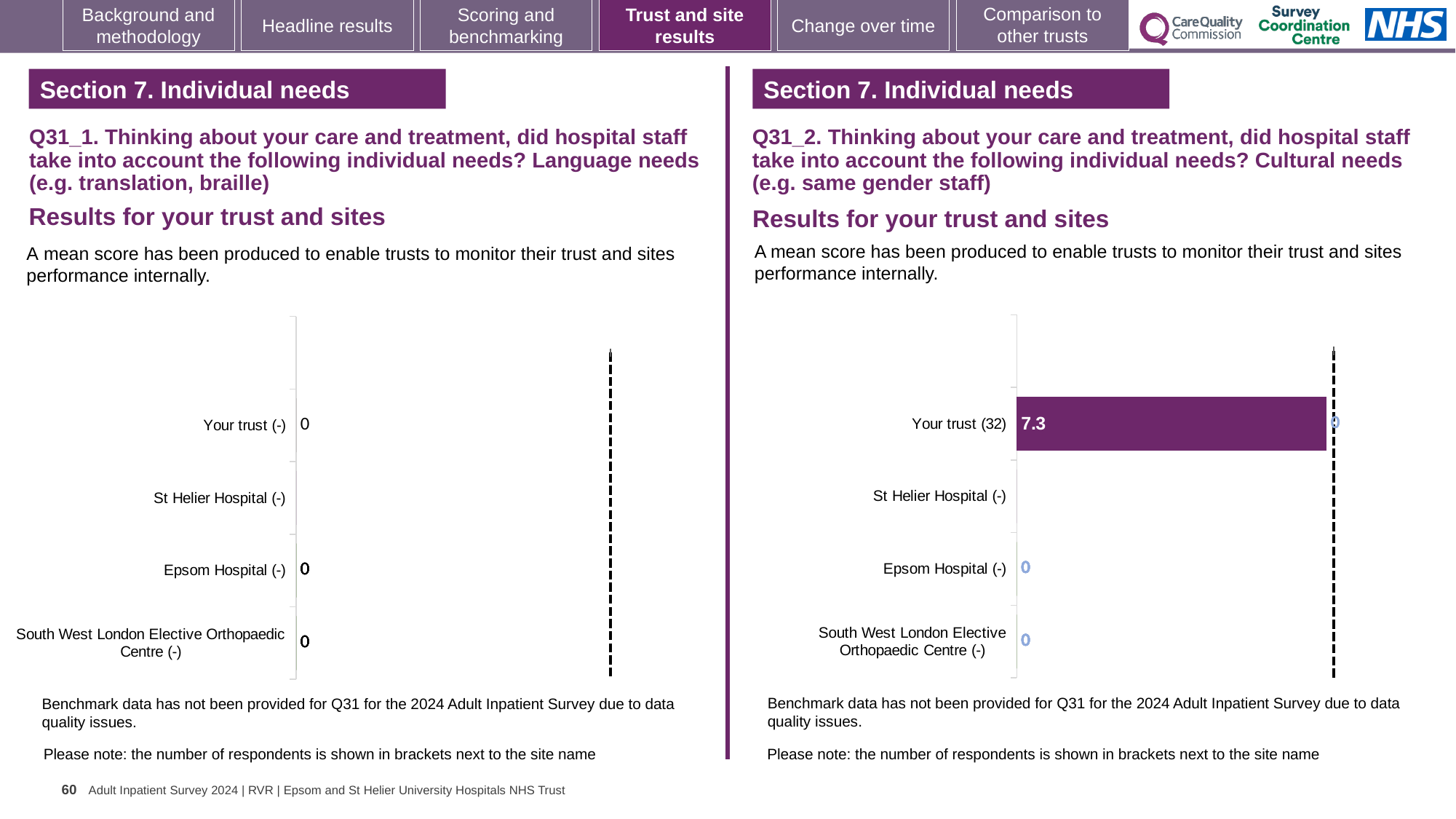
On the Q31_2 chart (right), which is larger: the value for Your trust (32) or the value for Epsom Hospital (-)? Your trust (32) On the Q31_2 chart (right), which category has the highest mean score? Your trust (32) On the Q31_2 chart (right), what value is shown for South West London Elective Orthopaedic Centre (-)? 0 On the Q31_2 chart (right), how many categories are listed on the vertical axis? 4 On the Q31_1 chart (left), what value is shown for Your trust (-)? 0 On the Q31_2 chart (right), how many respondents are shown in brackets for Your trust? 32 What kind of chart is used on the Q31_2 chart (right)? Bar chart On the Q31_2 chart (right), what is the difference between the value for Your trust (32) and the value for Epsom Hospital (-)? 7.3 On the Q31_2 chart (right), what is the mean score for Your trust (32)? 7.3 According to the note below the charts, why has benchmark data not been provided for Q31? Due to data quality issues On the Q31_1 chart (left), what value is shown for Epsom Hospital (-)? 0 On the Q31_1 chart (left), how many categories are listed on the vertical axis? 4